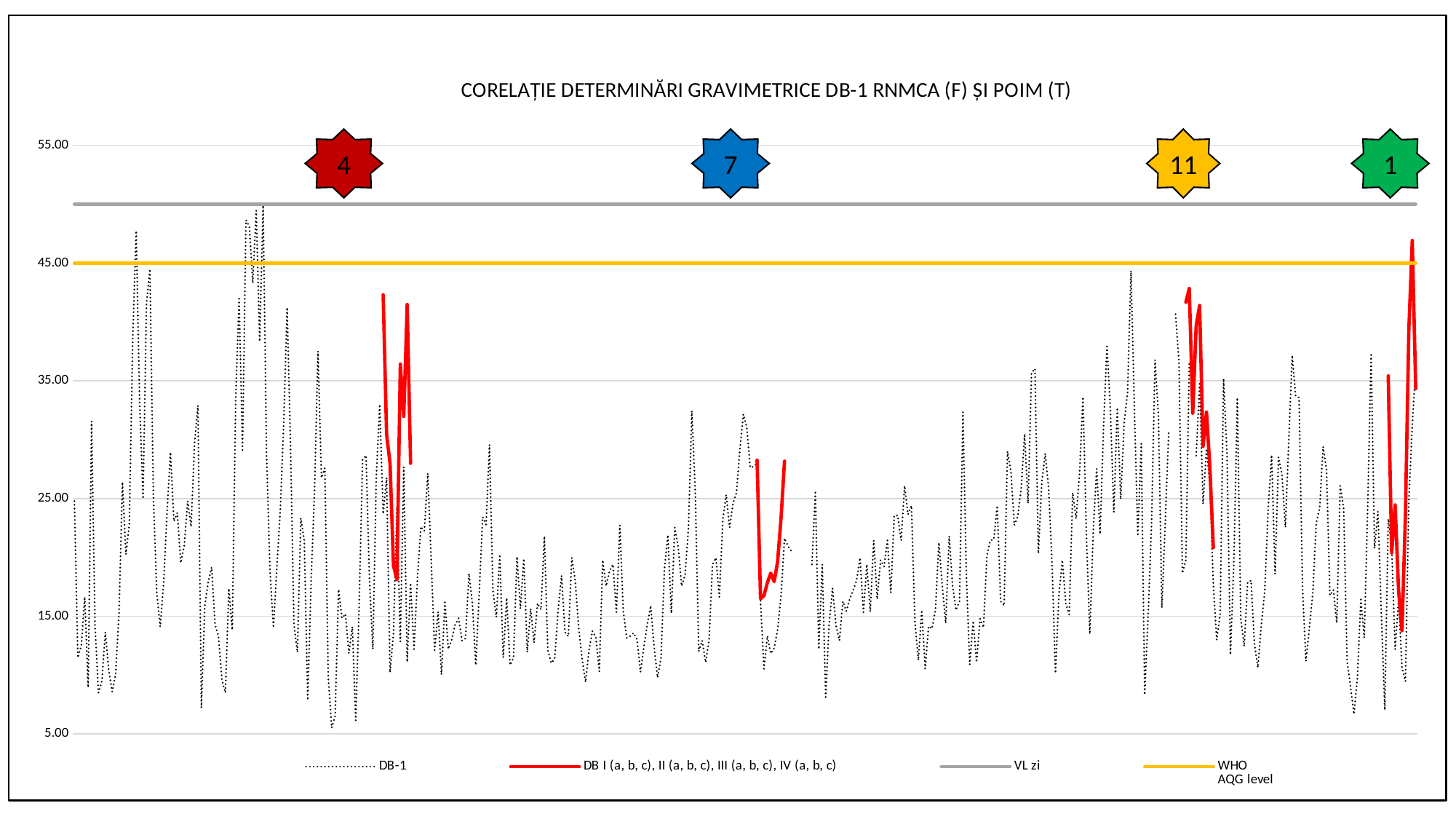
Which horizontal reference line is higher, VL zi or WHO AQG level? VL zi Is the VL zi line greater or less than 55? less What value does the WHO AQG level line sit at on the y axis? 45.00 Is the highest peak of the red series greater or less than 45? greater What numbers appear in the four star shapes above the chart, from left to right? 4, 7, 11, 1 How many tick labels are shown on the y axis? 6 What kind of chart is shown on the slide? line chart Is the VL zi line greater or less than 45? greater How many series does the legend list? 4 What is the highest value shown on the y axis? 55.00 What is the title of the chart? CORELAȚIE DETERMINĂRI GRAVIMETRICE DB-1 RNMCA (F) ȘI POIM (T) What is the lowest value shown on the y axis? 5.00